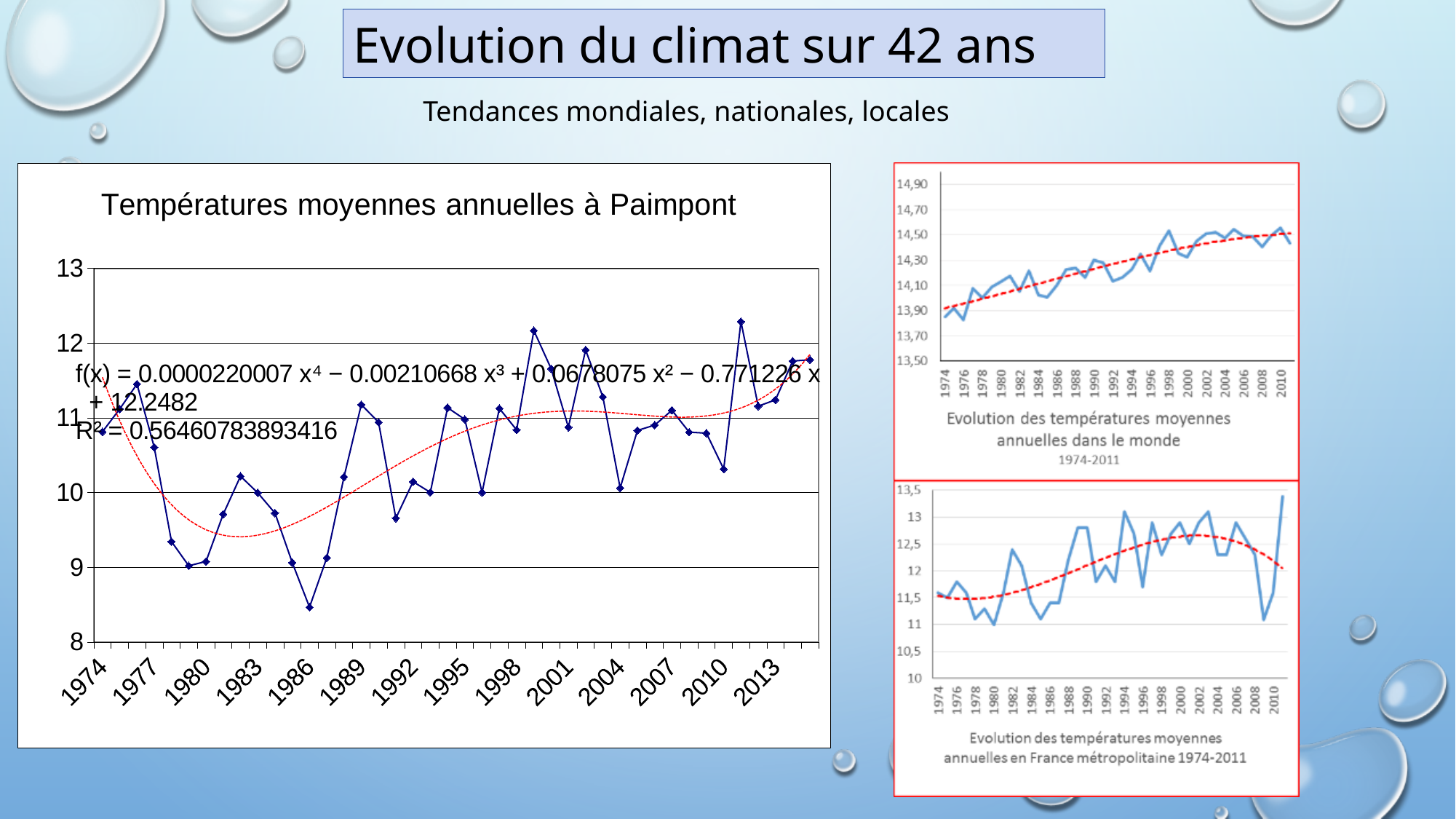
In the chart 'Evolution des températures moyennes annuelles dans le monde 1974-2011', is the value for 1974 greater or less than 14,10? less In the 'Températures moyennes annuelles à Paimpont' chart, is the value for 1999 greater or less than 12? greater In the 'Températures moyennes annuelles à Paimpont' chart, which year has the lowest temperature? 1986 In the chart 'Evolution des températures moyennes annuelles en France métropolitaine 1974-2011', what colour is the dashed trend line? red In the chart 'Evolution des températures moyennes annuelles dans le monde 1974-2011', do the values generally rise or fall from 1974 to 2010? rise In the 'Températures moyennes annuelles à Paimpont' chart, is the value for 1991 greater or less than 10? less In the 'Températures moyennes annuelles à Paimpont' chart, which is higher, the value for 1976 or the value for 1979? 1976 How many charts are shown on the slide? 3 What kind of chart is 'Températures moyennes annuelles à Paimpont'? line chart What R² value is printed on the 'Températures moyennes annuelles à Paimpont' chart? 0.56460783893416